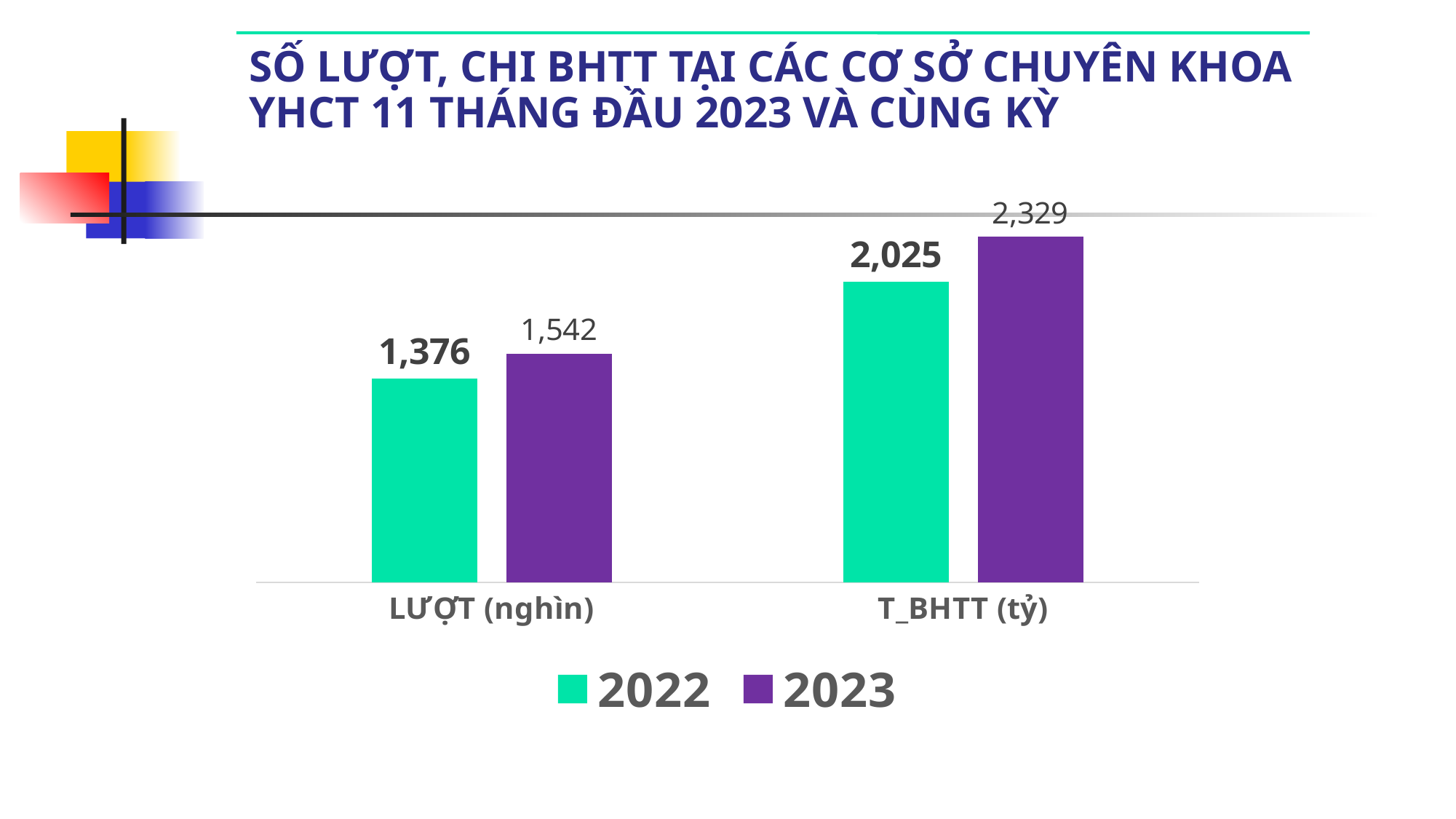
What is the difference between the 2023 and 2022 values for T_BHTT (tỷ)? 304 How many categories are shown on the x axis? 2 What is the 2023 value for LƯỢT (nghìn)? 1,542 What is the 2022 value for LƯỢT (nghìn)? 1,376 How many series does the legend list? 2 What is the 2022 value for T_BHTT (tỷ)? 2,025 What is the 2023 value for T_BHTT (tỷ)? 2,329 Which bar has the highest value on the chart? T_BHTT (tỷ) in 2023 What is the difference between the 2023 and 2022 values for LƯỢT (nghìn)? 166 What kind of chart is shown on the slide? Bar chart For T_BHTT (tỷ), which year has the larger value, 2022 or 2023? 2023 Which bar has the lowest value on the chart? LƯỢT (nghìn) in 2022